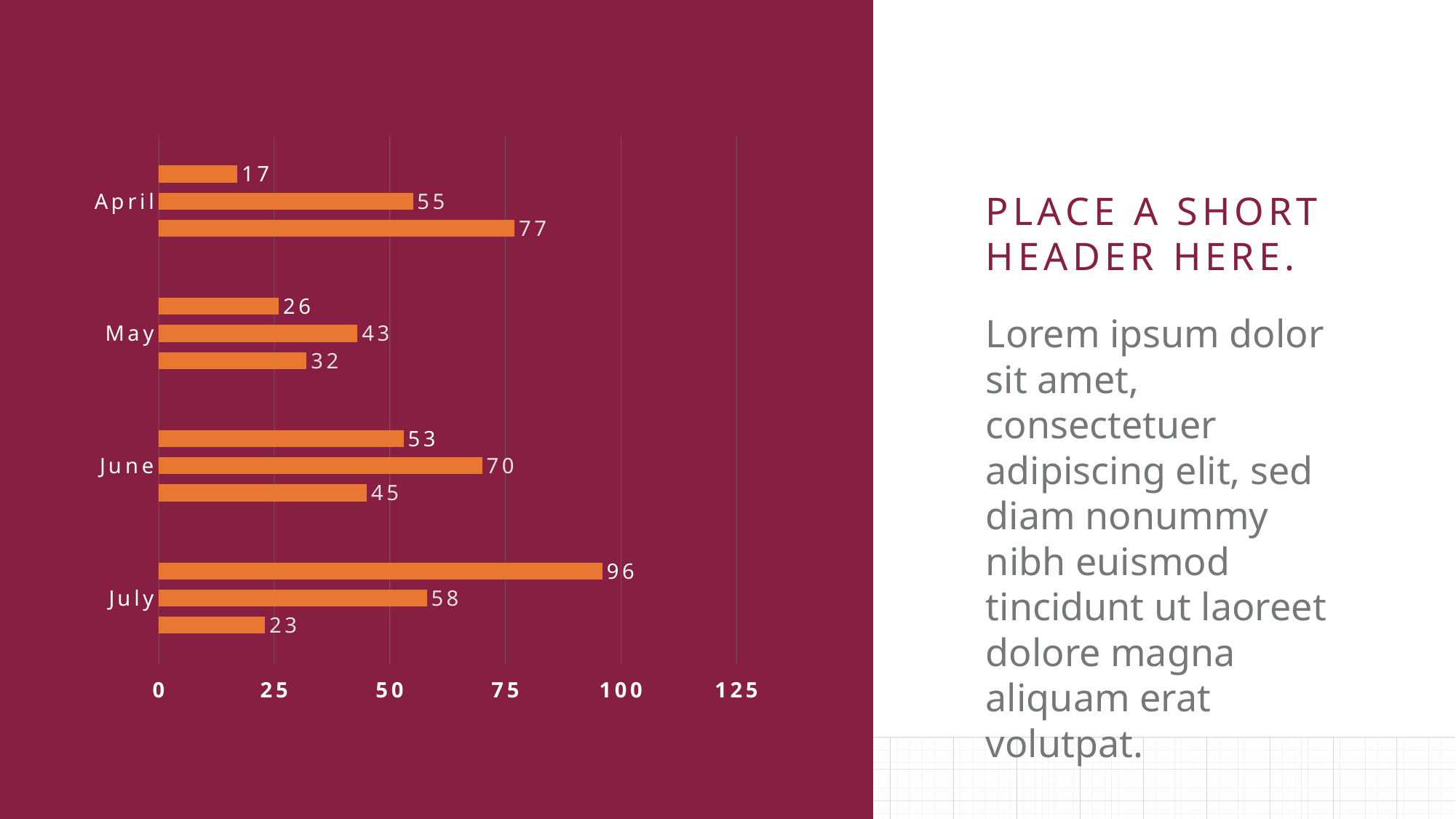
Which category contains the single lowest value on the chart? April Which is larger: the middle bar in the April group or the middle bar in the May group? April Which category contains the single highest value on the chart? July What is the value of the bottom bar in the July group? 23 What is the total of the three bars in the May group? 101 What is the value of the longest bar in the April group? 77 What is the difference between the top bar in the July group (96) and the top bar in the April group (17)? 79 What is the value of the middle bar in the June group? 70 What is the value of the top bar in the May group? 26 What is the highest tick value shown on the horizontal axis? 125 How many categories are shown on the chart's vertical axis? 4 What kind of chart is shown on the slide? bar chart